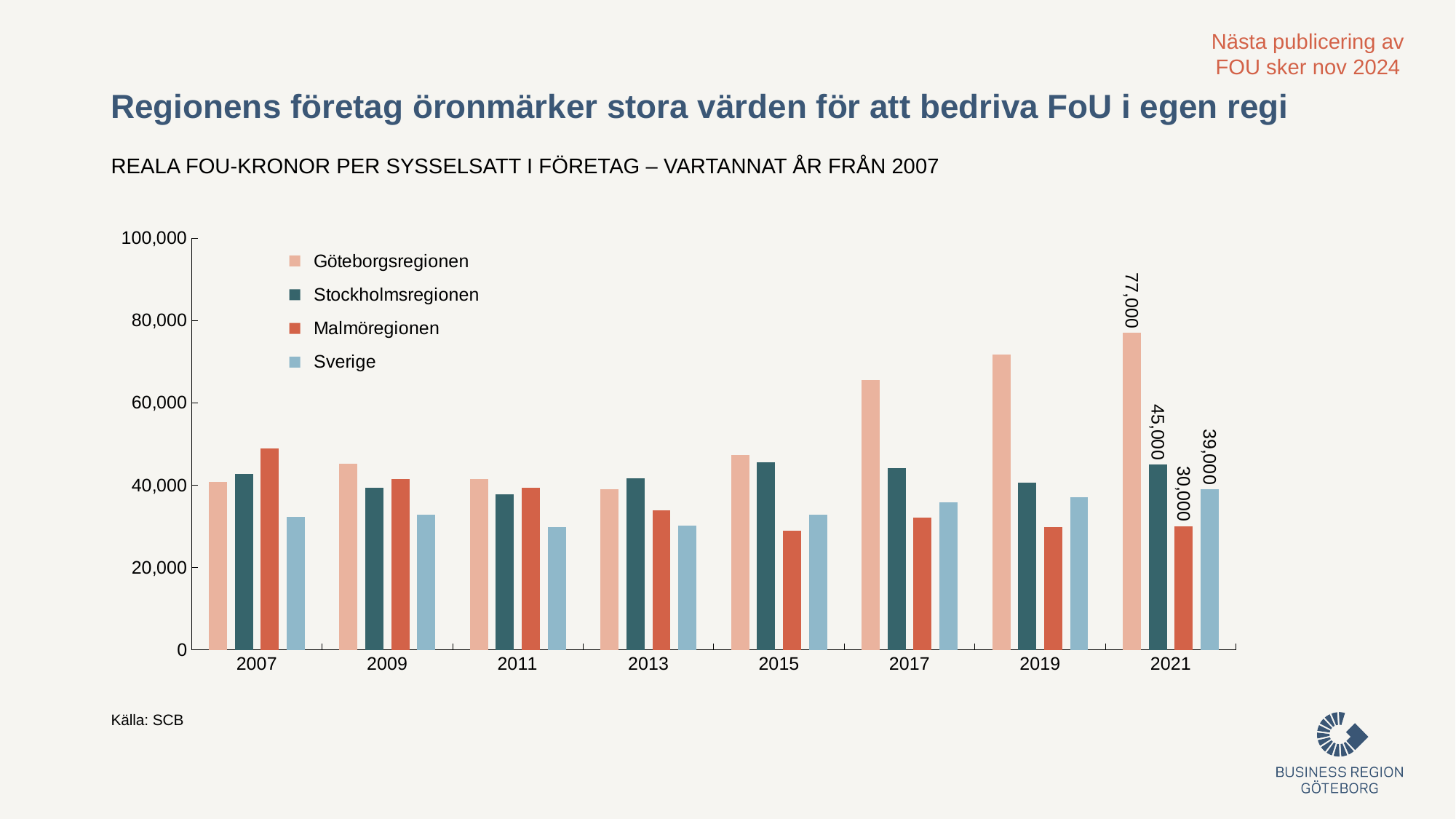
What is the value for Sverige in 2021? 39,000 What is the value for Malmöregionen in 2021? 30,000 Which series has the lowest value in 2021? Malmöregionen In 2007, which is larger: Malmöregionen or Göteborgsregionen? Malmöregionen Which series has the highest value in 2021? Göteborgsregionen What is the value for Stockholmsregionen in 2021? 45,000 How many years are shown on the x axis? 8 Is the value for Göteborgsregionen in 2019 greater or less than 60,000? greater How many series does the legend list? 4 What kind of chart is shown on the slide? Bar chart What is the difference between Göteborgsregionen and Stockholmsregionen in 2021? 32,000 What is the value for Göteborgsregionen in 2021? 77,000